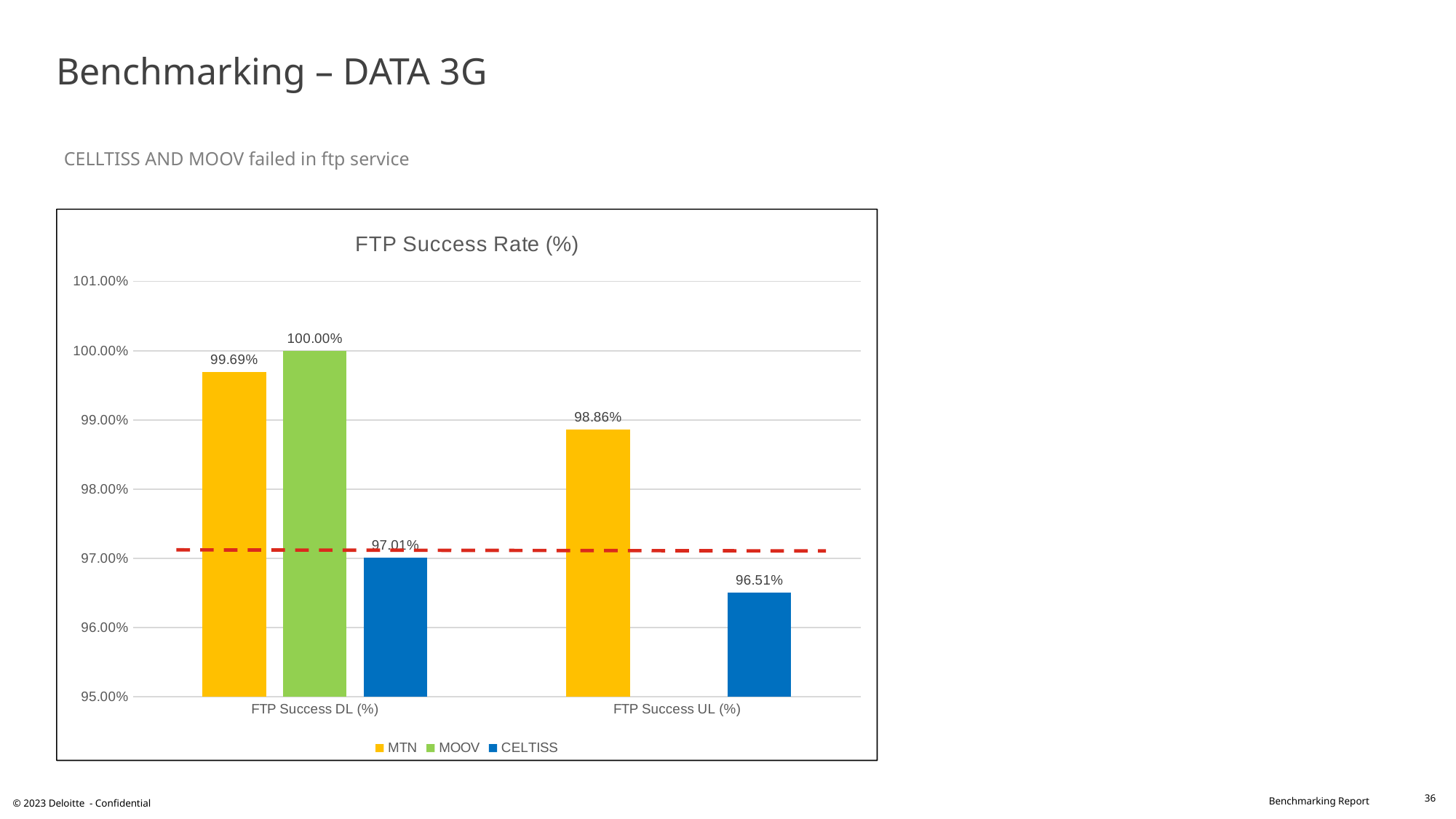
What is the FTP Success DL (%) value for MOOV? 100.00% What is the FTP Success DL (%) value for MTN? 99.69% How many series does the legend list? 3 Which is larger: CELTISS's FTP Success DL (%) or its FTP Success UL (%)? FTP Success DL (%) What is the difference between MTN's FTP Success DL (%) and its FTP Success UL (%)? 0.83% What is the FTP Success UL (%) value for MTN? 98.86% What is the title of the chart? FTP Success Rate (%) Which operator has the highest FTP Success DL (%)? MOOV What kind of chart is shown on the slide? Bar chart Is the FTP Success UL (%) value for CELTISS greater or less than 97.00%? less What is the FTP Success UL (%) value for CELTISS? 96.51%